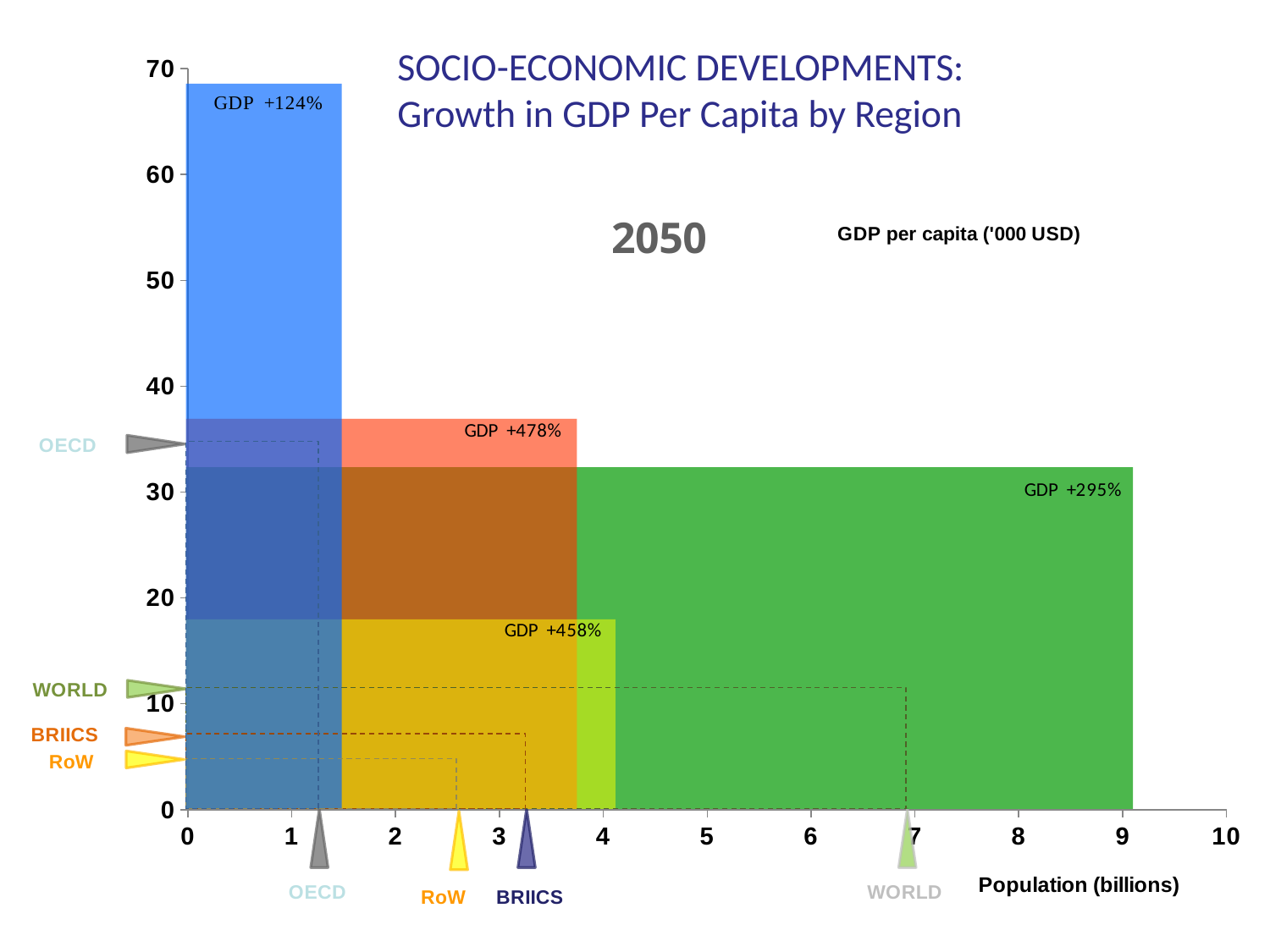
What GDP growth percentage is printed for the WORLD region? +295% Which region has the lowest printed GDP growth percentage? OECD Is the GDP per capita value for OECD greater or less than 60? greater Which region has the highest printed GDP growth percentage? BRIICS Which region has the lowest GDP per capita in 2050 on the chart? RoW What is the difference between the printed GDP growth percentages for BRIICS and RoW? 20 percentage points What year does the chart show? 2050 What GDP growth percentage is printed for the OECD region? +124% What GDP growth percentage is printed for the BRIICS region? +478% Which region has the highest GDP per capita in 2050 on the chart? OECD Is the GDP per capita value for RoW greater or less than 20? less What GDP growth percentage is printed for the RoW region? +458%